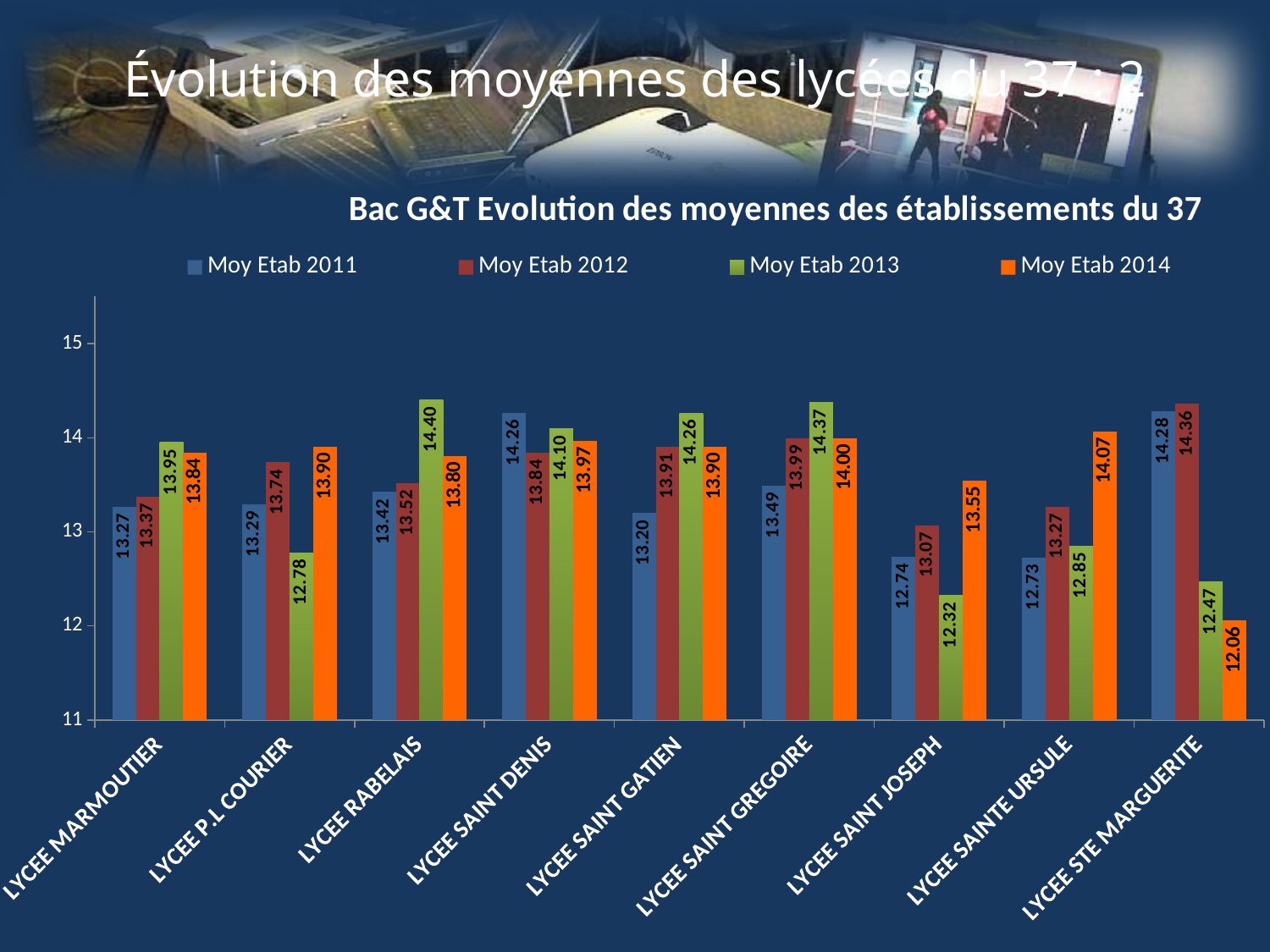
Is the Moy Etab 2013 value for LYCEE P.L COURIER greater or less than 13? less What is the Moy Etab 2014 value for LYCEE STE MARGUERITE? 12.06 What is the difference between the Moy Etab 2014 and Moy Etab 2013 values for LYCEE SAINT JOSEPH? 1.23 How many series does the legend list? 4 What is the Moy Etab 2011 value for LYCEE SAINT JOSEPH? 12.74 How many lycées are shown on the x axis of the chart? 9 What kind of chart is shown on the slide? bar chart What is the Moy Etab 2013 value for LYCEE RABELAIS? 14.40 Which lycée has the lowest Moy Etab 2013 value? LYCEE SAINT JOSEPH Which lycée has the highest Moy Etab 2014 value? LYCEE SAINTE URSULE What is the difference between the Moy Etab 2012 and Moy Etab 2014 values for LYCEE STE MARGUERITE? 2.30 Which has the larger Moy Etab 2011 value, LYCEE SAINT DENIS or LYCEE SAINT GATIEN? LYCEE SAINT DENIS